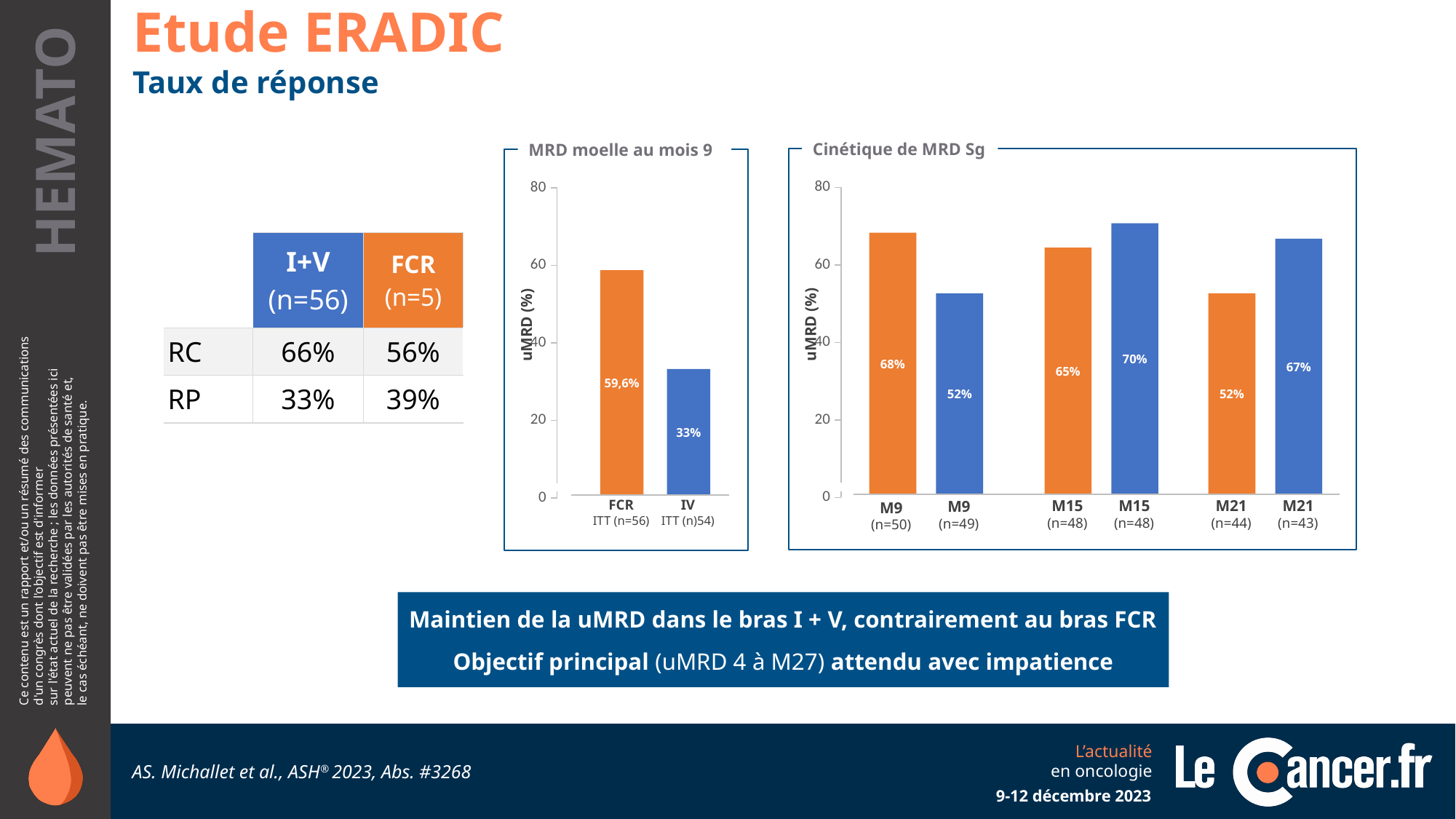
In the 'MRD moelle au mois 9' chart, how many bars are plotted? 2 What is the y-axis label of the 'MRD moelle au mois 9' chart? uMRD (%) In the 'MRD moelle au mois 9' chart, what is the value for FCR? 59,6% In the 'Cinétique de MRD Sg' chart, how many bars are plotted? 6 In the 'Cinétique de MRD Sg' chart, which bar has the highest value? M15 (n=48), blue bar, 70% In the 'Cinétique de MRD Sg' chart, what is the difference between the blue bar at M21 (n=43) and the orange bar at M21 (n=44)? 15% In the 'Cinétique de MRD Sg' chart, what is the value of the orange bar at M21 (n=44)? 52% In the 'Cinétique de MRD Sg' chart, what is the value of the orange bar at M9 (n=50)? 68% What kind of chart is 'Cinétique de MRD Sg'? Bar chart In the 'MRD moelle au mois 9' chart, which bar is higher, FCR or IV? FCR In the 'Cinétique de MRD Sg' chart, what is the value of the blue bar at M15 (n=48)? 70% In the 'MRD moelle au mois 9' chart, what is the value for IV? 33%